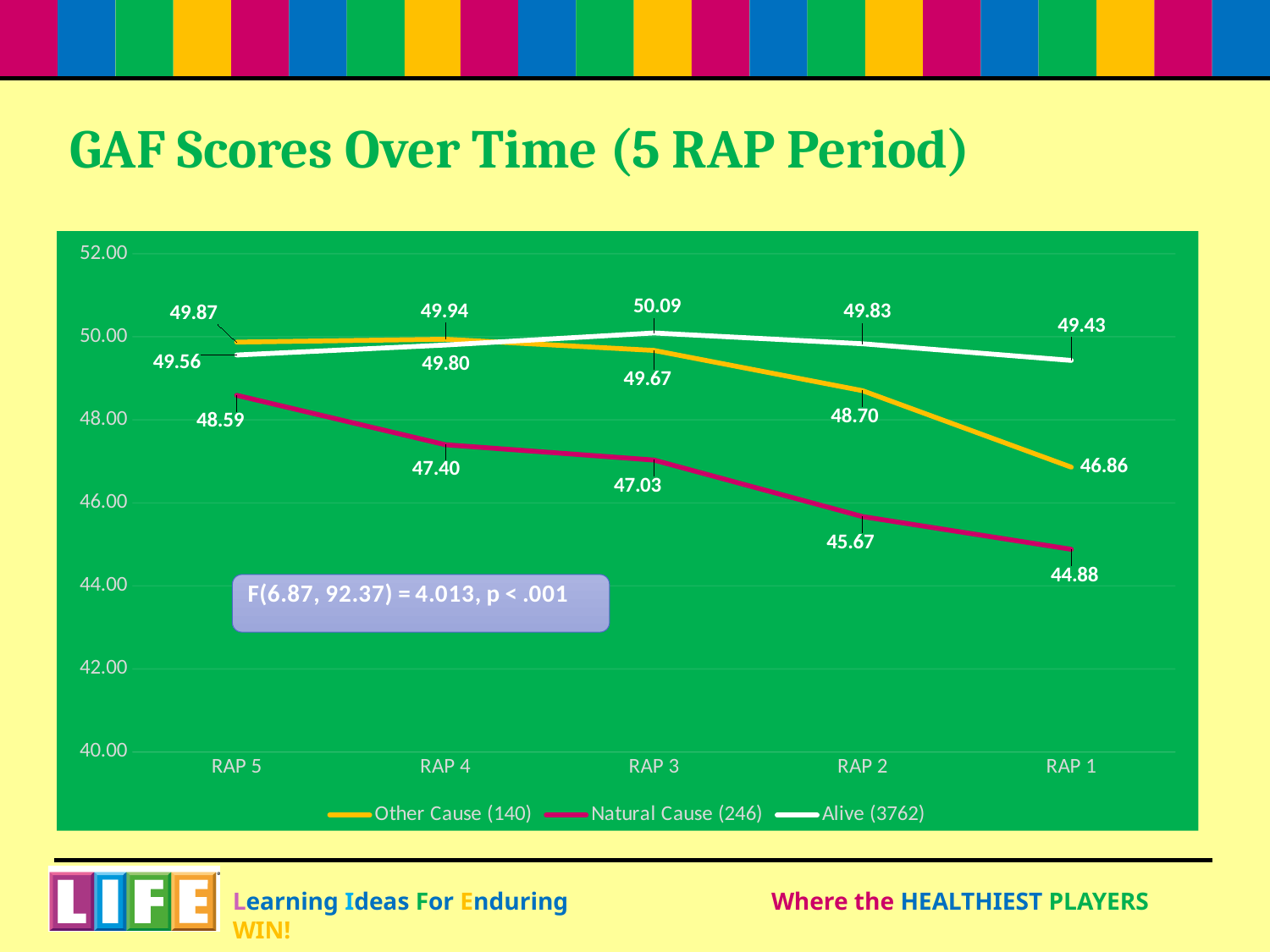
What is the GAF score for Alive (3762) at RAP 3? 50.09 What is the difference between the Alive (3762) score and the Natural Cause (246) score at RAP 1? 4.55 What type of chart is shown on the slide? line chart How many series does the legend list? 3 Does the Natural Cause (246) score rise or fall from RAP 5 to RAP 1? fall At which RAP period is the Natural Cause (246) score highest? RAP 5 What statistical result is shown in the box on the chart? F(6.87, 92.37) = 4.013, p < .001 How many RAP periods are shown on the x axis? 5 What is the GAF score for Natural Cause (246) at RAP 1? 44.88 At RAP 2, which series has the higher score: Other Cause (140) or Natural Cause (246)? Other Cause (140) At which RAP period is the Other Cause (140) score lowest? RAP 1 What is the GAF score for Other Cause (140) at RAP 2? 48.70